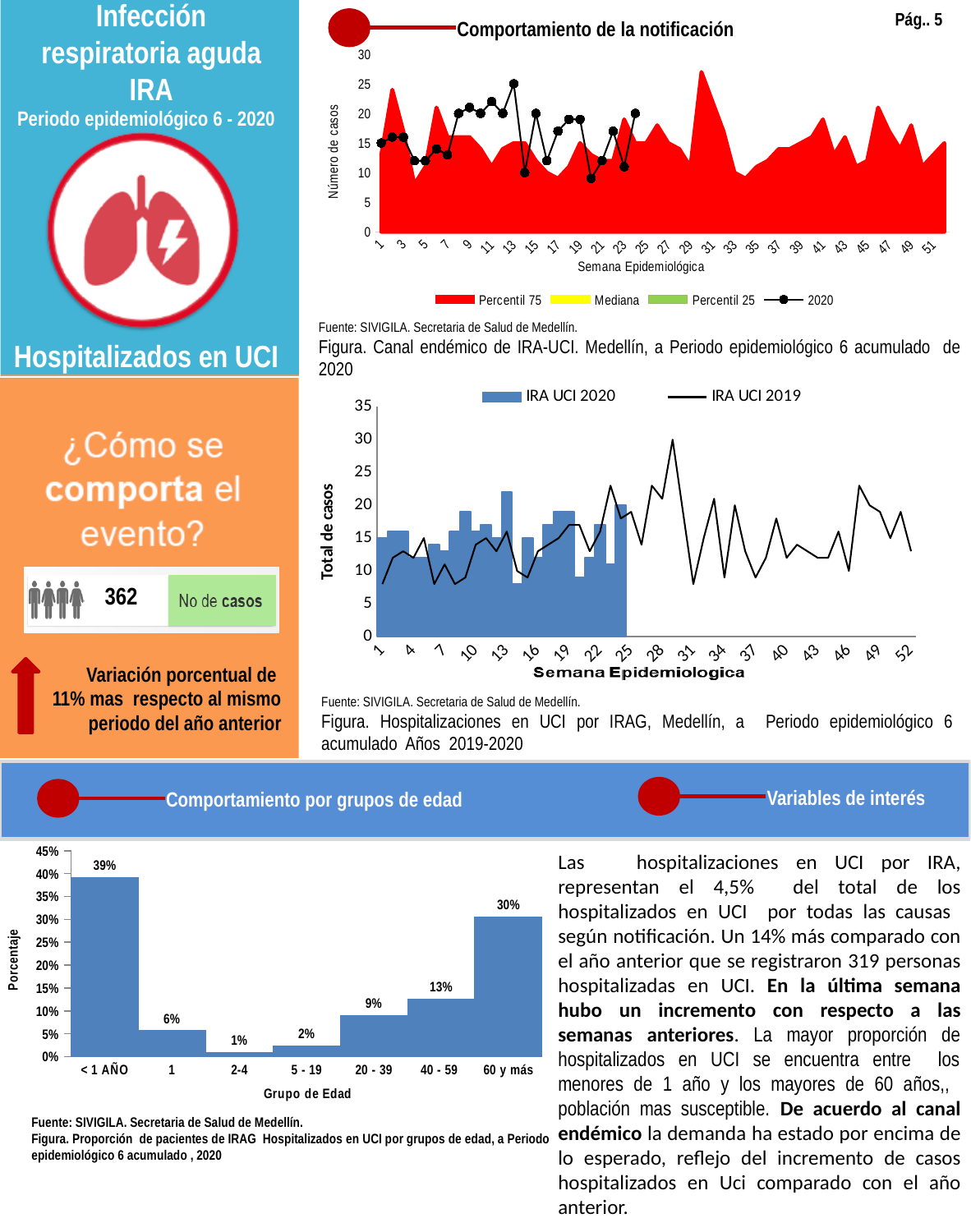
In the bottom-left chart 'Comportamiento por grupos de edad', which age group has the highest percentage? < 1 AÑO What type of chart is the bottom-left chart 'Comportamiento por grupos de edad'? Bar chart In the bottom-left chart 'Comportamiento por grupos de edad', which age group has the lowest percentage? 2-4 In the bottom-left chart 'Comportamiento por grupos de edad', what is the percentage for the '< 1 AÑO' age group? 39% In the bottom-left chart 'Comportamiento por grupos de edad', what is the difference in percentage points between the '< 1 AÑO' group and the '60 y más' group? 9 percentage points In the bottom-left chart 'Comportamiento por grupos de edad', which has a larger percentage: the '20 - 39' group or the '1' group? 20 - 39 How many series does the legend of the top-right chart 'Comportamiento de la notificación' list? 4 How many series does the legend of the middle-right chart 'Hospitalizaciones en UCI por IRAG' list? 2 In the bottom-left chart 'Comportamiento por grupos de edad', what is the percentage for the '60 y más' age group? 30% In the middle-right chart 'Hospitalizaciones en UCI por IRAG', is the IRA UCI 2020 value at week 13 greater or less than 20? greater How many age groups are shown in the bottom-left chart 'Comportamiento por grupos de edad'? 7 In the bottom-left chart 'Comportamiento por grupos de edad', what is the percentage for the '40 - 59' age group? 13%